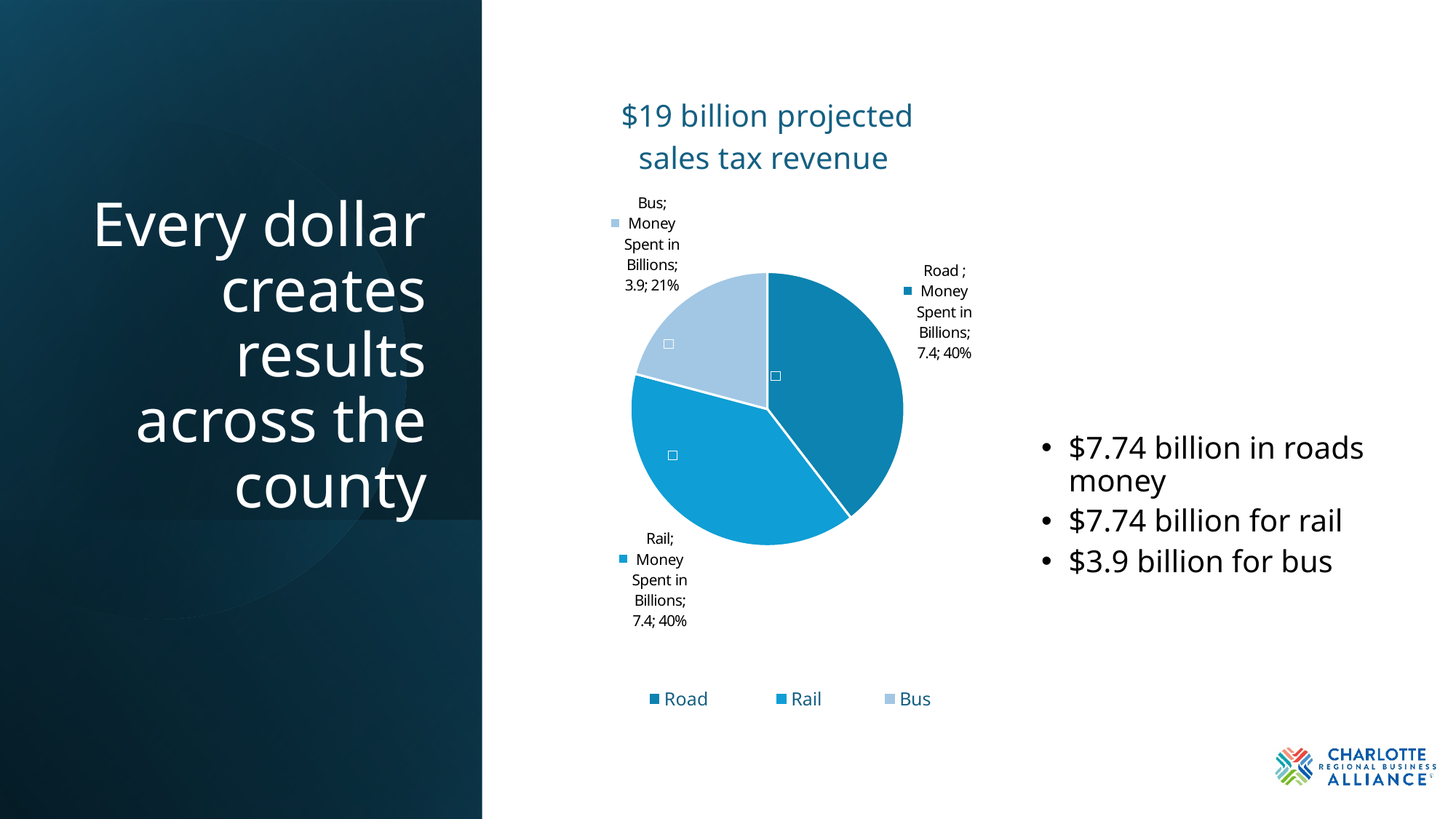
What value (Money Spent in Billions) is shown for the Rail slice? 7.4 How many slices does the pie chart have? 3 What percentage share of the pie does the Bus slice represent? 21% What is the title of the chart? $19 billion projected sales tax revenue Which category has the smallest slice of the pie? Bus How many entries does the chart legend list? 3 Which is larger, the Road slice or the Bus slice? Road What is the difference in Money Spent in Billions between Road and Bus? 3.5 What type of chart is shown on the slide? pie chart What percentage share of the pie does the Road slice represent? 40% What value (Money Spent in Billions) is shown for the Bus slice? 3.9 What value (Money Spent in Billions) is shown for the Road slice? 7.4